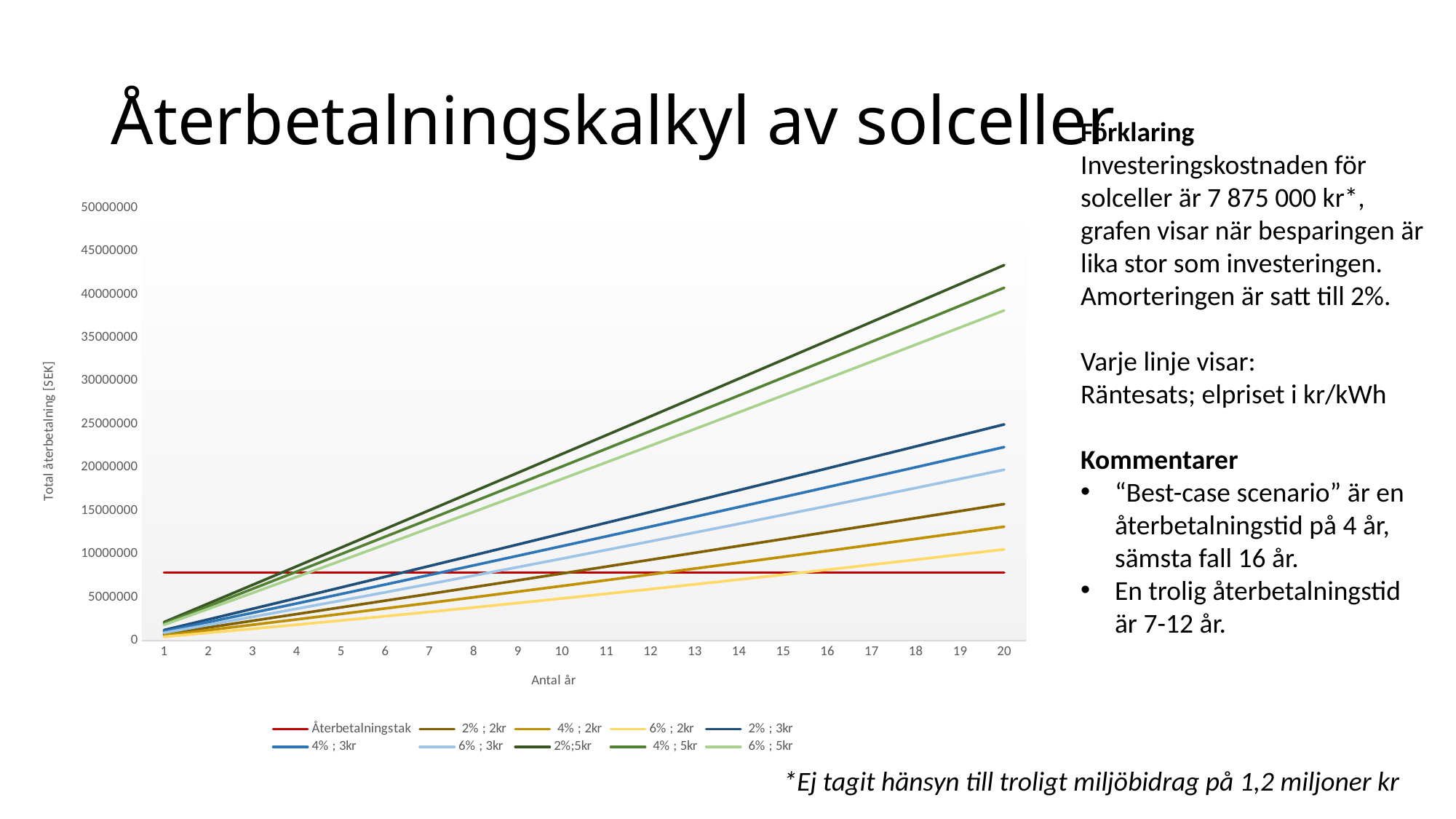
Is the value for 4% ; 2kr at year 20 greater or less than 15000000? less Is the value for 2%;5kr at year 20 greater or less than 40000000? greater Which of the rising series has the lowest value at year 20? 6% ; 2kr Do the values for 4% ; 3kr rise or fall as the number of years increases? rise How many years are shown along the x axis of the chart? 20 How many series does the chart legend list? 10 Is the value for 6% ; 5kr at year 20 greater or less than 40000000? less At year 20, which is larger: the value for 2%;5kr or the value for 6% ; 2kr? 2%;5kr Which series has the highest value at year 20? 2%;5kr What kind of chart is shown on the slide? line chart What is the label of the y axis of the chart? Total återbetalning [SEK]